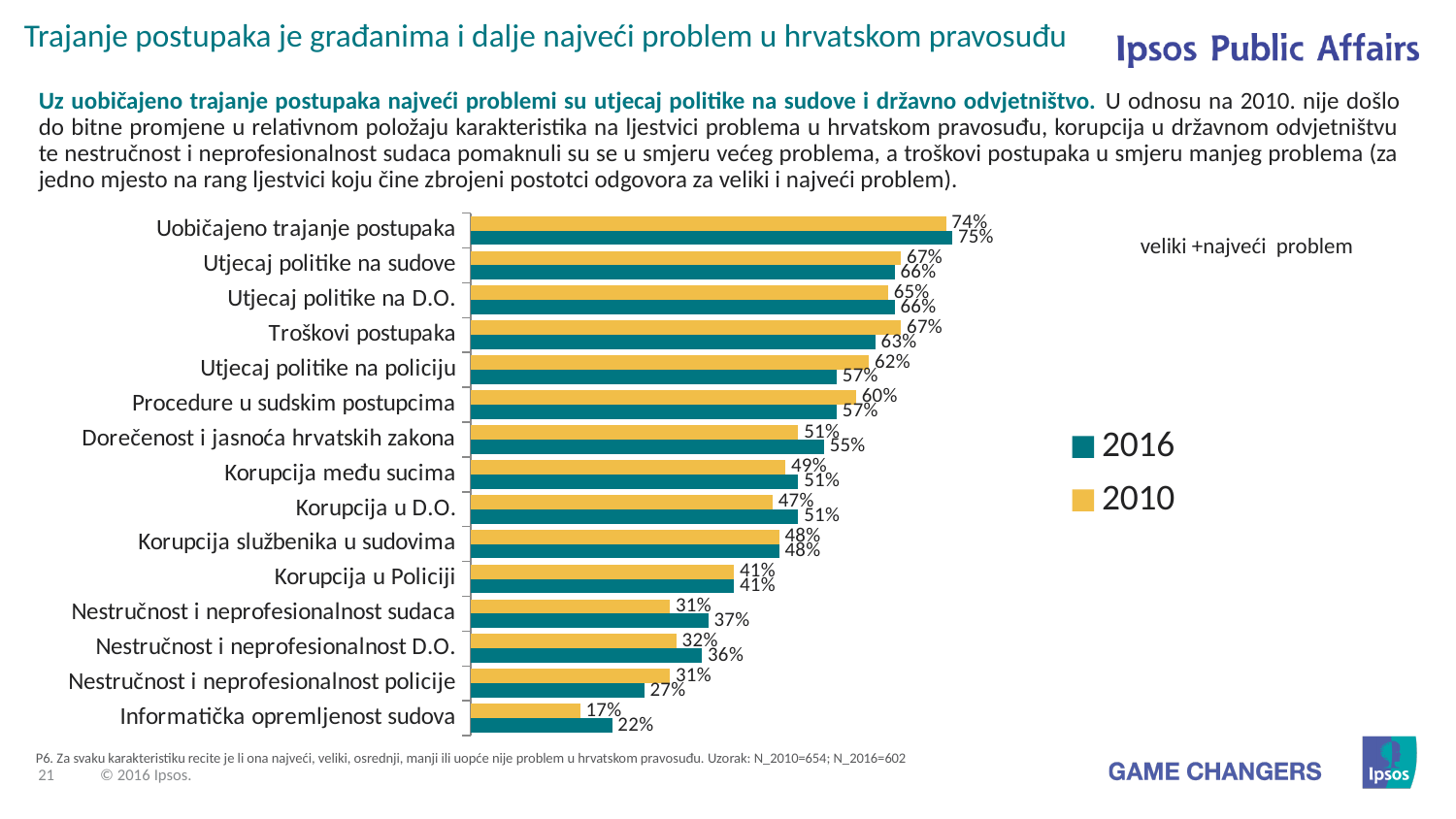
What is the 2016 value for Uobičajeno trajanje postupaka? 75% Which category has the highest 2016 value? Uobičajeno trajanje postupaka What is the 2010 value for Nestručnost i neprofesionalnost sudaca? 31% What type of chart is shown on the slide? Bar chart What is the difference between the 2016 and 2010 values for Nestručnost i neprofesionalnost sudaca? 6 percentage points What is the 2010 value for Troškovi postupaka? 67% Which category has the lowest 2010 value? Informatička opremljenost sudova How many series does the legend list? 2 How many categories are shown in the chart? 15 Which colour represents the 2010 series in the chart? Yellow What is the 2016 value for Informatička opremljenost sudova? 22% For Troškovi postupaka, which year has the larger value, 2016 or 2010? 2010